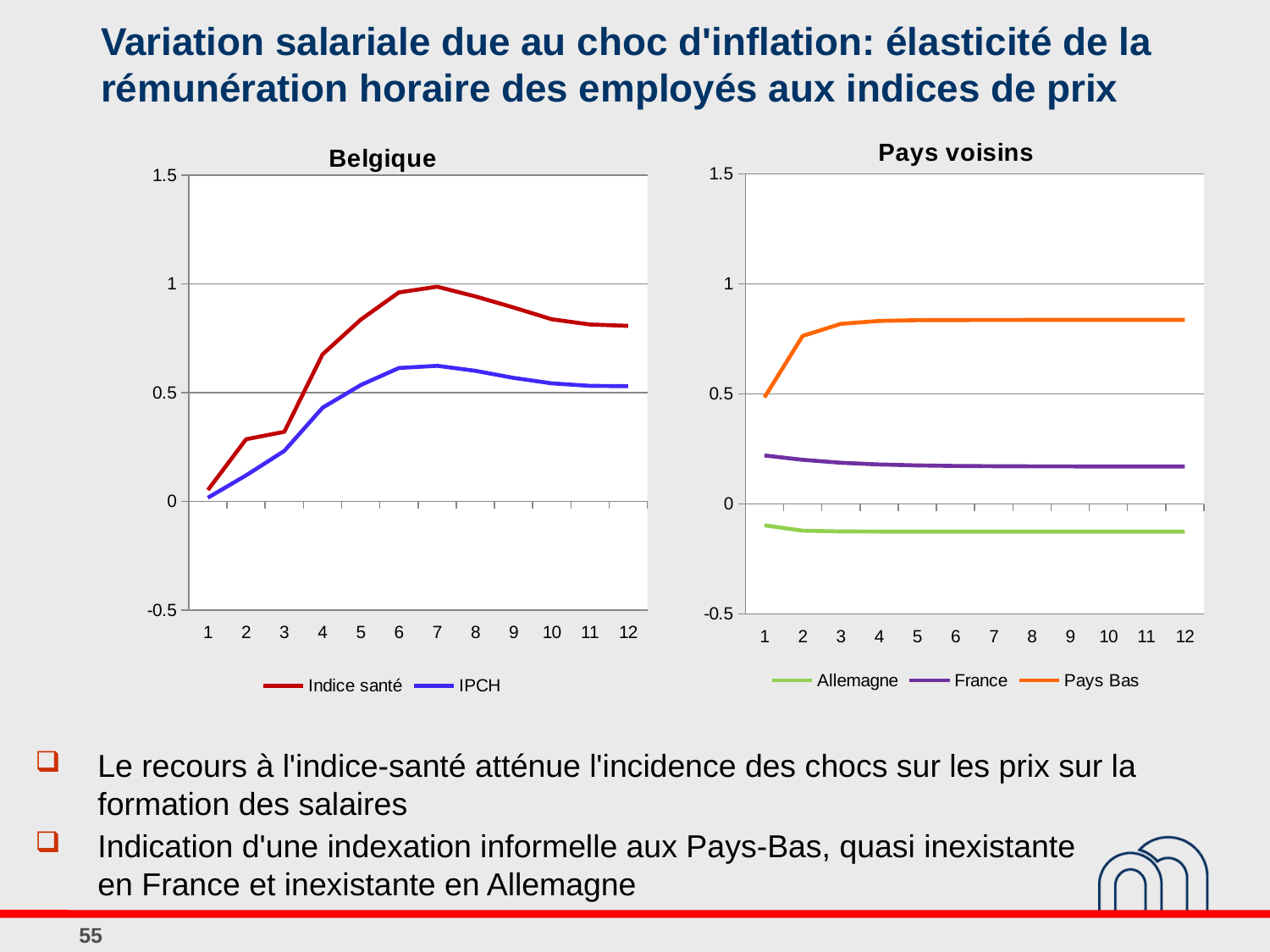
In the Pays voisins chart, is the value for Allemagne at point 6 greater or less than 0? less How many points are plotted along the x axis of the Belgique chart? 12 In the Belgique chart, does the Indice santé line rise or fall from point 7 to point 12? fall How many series does the legend of the Pays voisins chart list? 3 What kind of chart is the Belgique chart? line chart In the Pays voisins chart, which series is drawn in orange? Pays Bas How many series does the legend of the Belgique chart list? 2 In the Pays voisins chart, is the value for Pays Bas at point 12 greater or less than 0.5? greater In the Pays voisins chart, which series has the lowest values? Allemagne In the Belgique chart, which series has the larger value at point 7, Indice santé or IPCH? Indice santé In the Belgique chart, is the value of Indice santé at point 7 greater or less than 0.5? greater